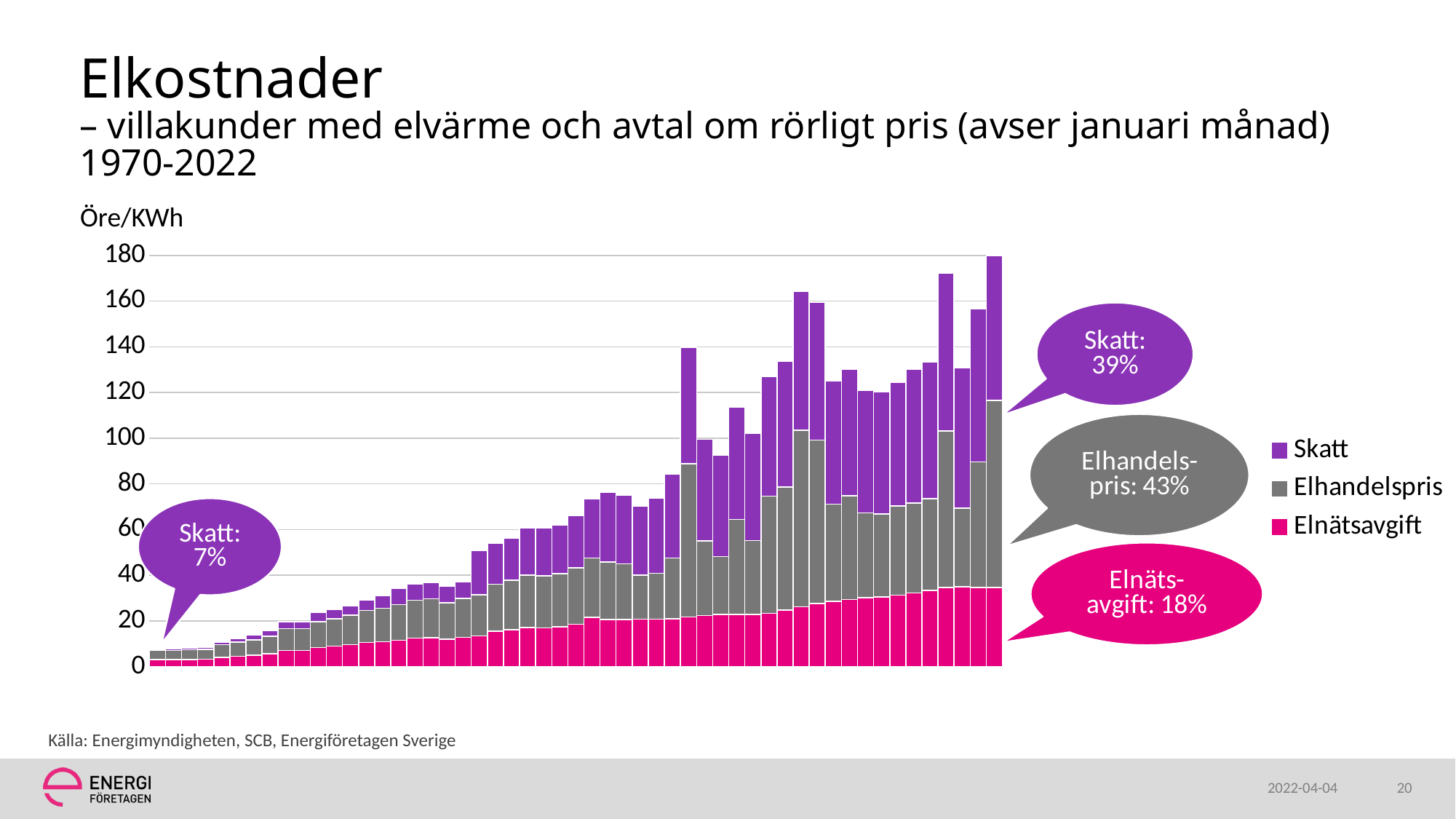
How many series does the legend list? 3 Is the total of the tallest (rightmost) bar greater or less than 160? greater According to the callout at the left of the chart, what share of the cost was Skatt in the early years? 7% According to the callout, what share of the cost is Skatt in the most recent year? 39% According to the callout, what share of the cost is Elhandelspris in the most recent year? 43% What unit is shown on the y axis of the chart? Öre/KWh Which series are listed in the legend? Skatt, Elhandelspris, Elnätsavgift What kind of chart is shown on the slide? Stacked bar chart According to the callout, what share of the cost is Elnätsavgift in the most recent year? 18% Is the total of the first (leftmost) bar greater or less than 20? less Do the total electricity costs generally rise or fall from left to right across the chart? rise Which series is plotted at the bottom of each stacked bar? Elnätsavgift